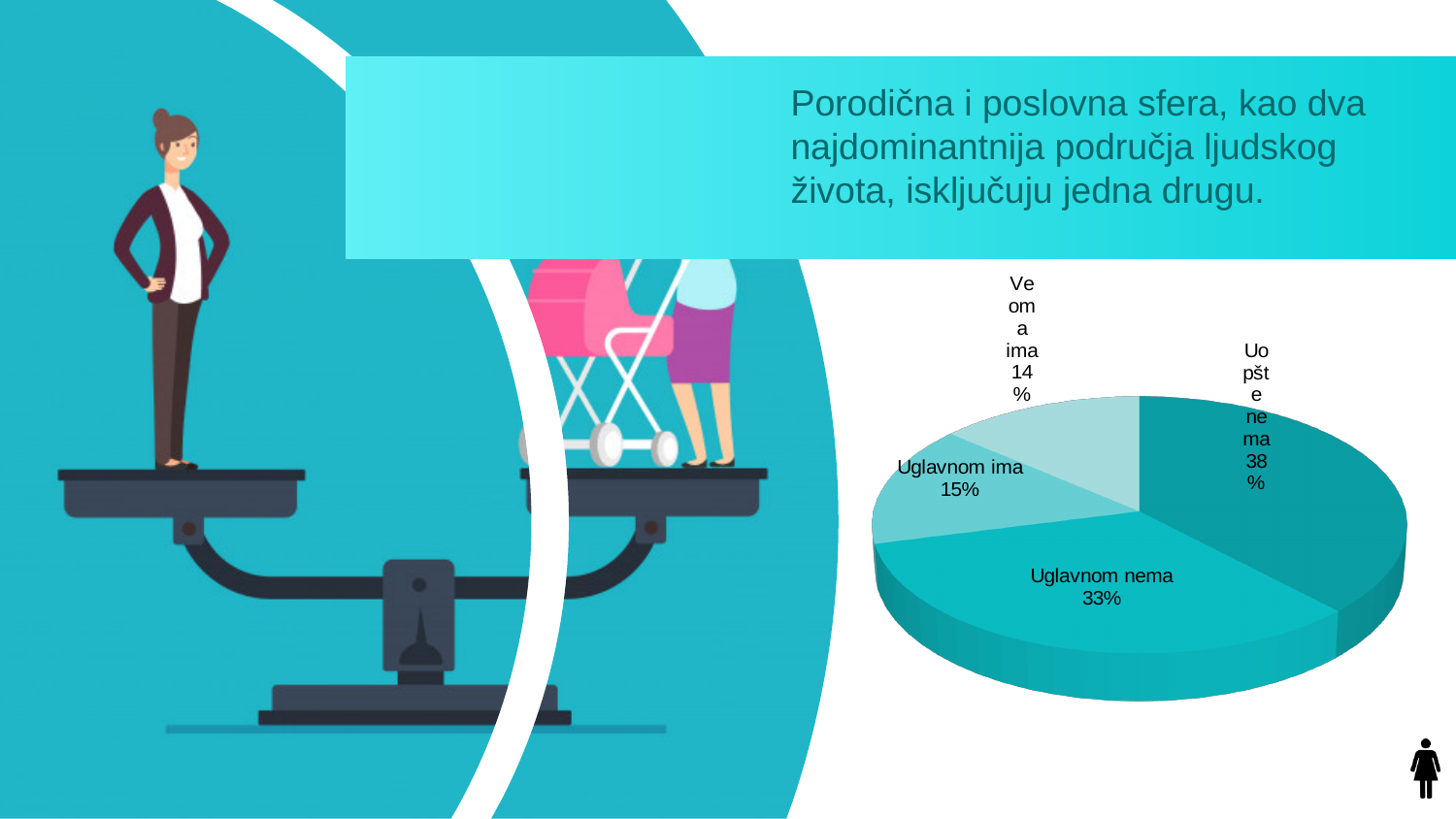
How many slices does the pie chart have? 4 What share of the pie is labelled "Veoma ima"? 14% What share of the pie is labelled "Uglavnom ima"? 15% What share of the pie is labelled "Uglavnom nema"? 33% Which slice of the pie chart is the largest? Uopšte nema Which slice of the pie chart is the smallest? Veoma ima Which is larger, the "Uglavnom nema" slice or the "Uglavnom ima" slice? Uglavnom nema What kind of chart is shown on the slide? pie chart What is the difference in percentage points between the "Uopšte nema" and "Uglavnom nema" slices? 5 Is the pie chart drawn in 3D or flat 2D? 3D What is the combined share of the "Uglavnom ima" and "Veoma ima" slices? 29%